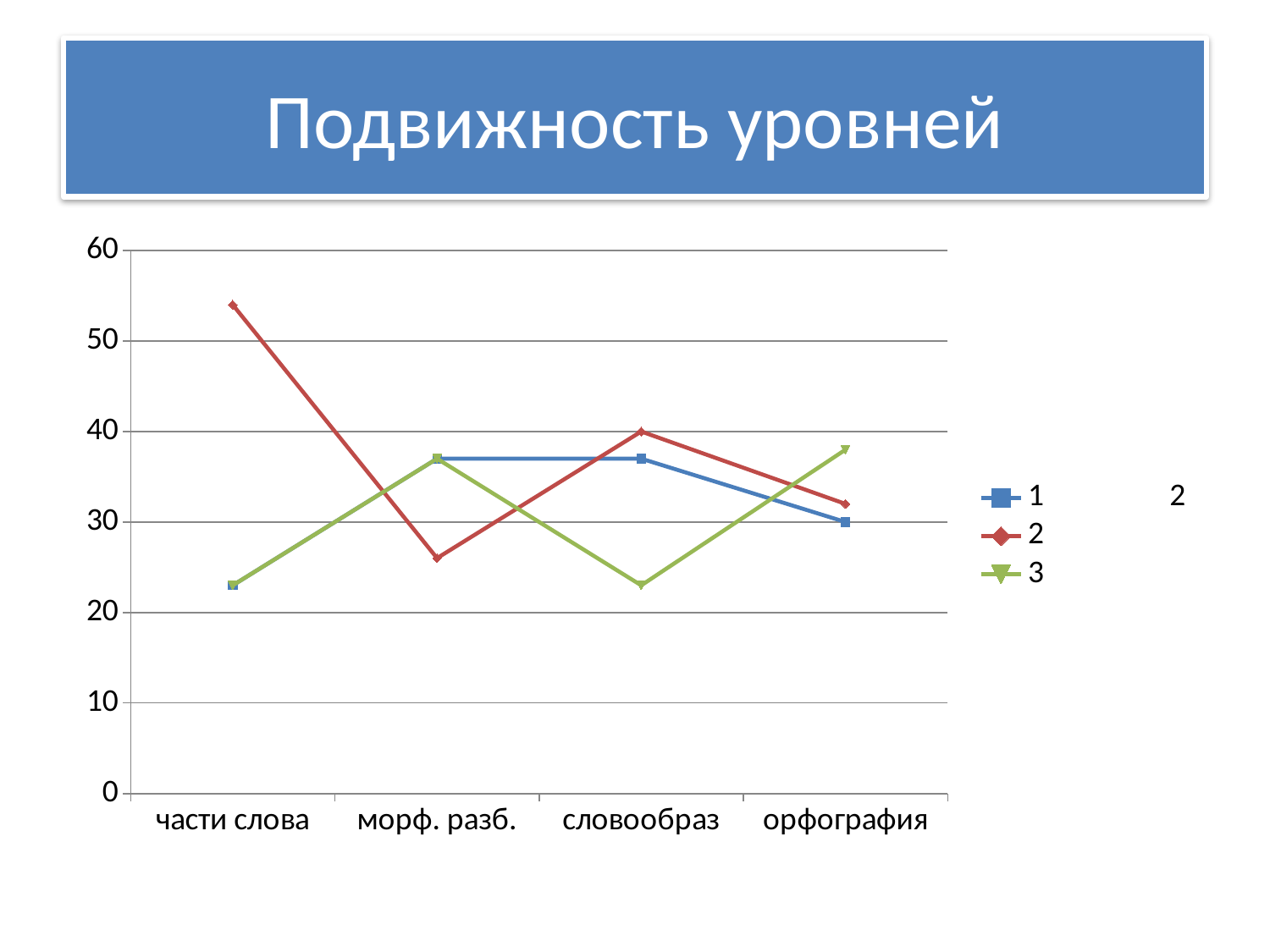
How many series does the legend list? 3 Does series 1 rise or fall from словообраз to орфография? fall What is the title of the chart? Подвижность уровней Is the value of series 2 for части слова greater or less than 50? greater How many categories are shown on the x axis? 4 Is the value of series 3 for словообраз greater or less than 30? less Is the value of series 2 for морф. разб. greater or less than 30? less For which category does series 2 have its lowest value? морф. разб. What kind of chart is shown on the slide? line chart For части слова, which series has the larger value, series 1 or series 2? series 2 For which category does series 2 reach its highest value? части слова